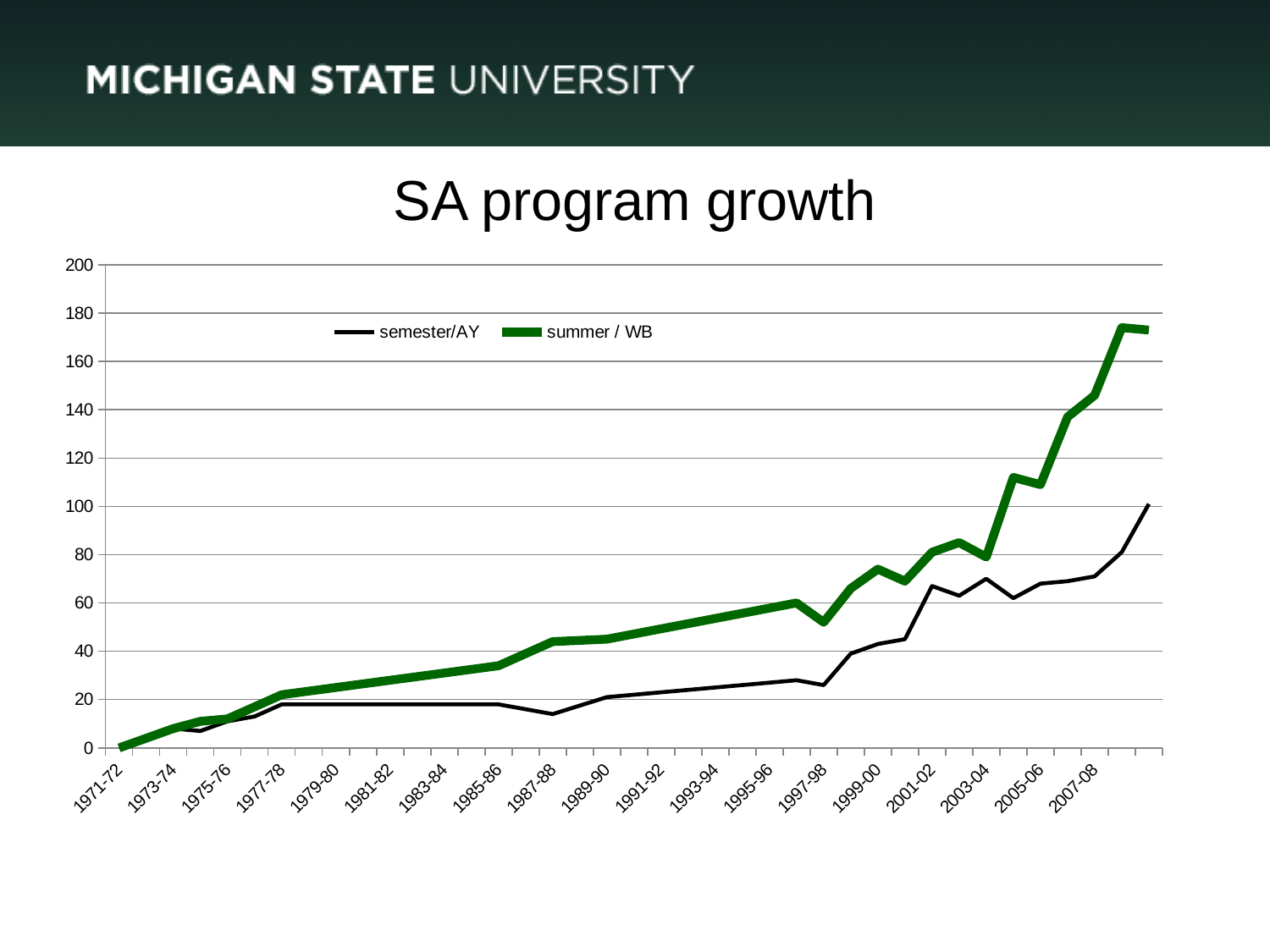
Is the value for summer / WB at 2003-04 greater or less than 100? less What kind of chart is shown on the slide? line chart Is the value for summer / WB at 1997-98 greater or less than 60? less Is the value for semester/AY at 2007-08 greater or less than 60? greater Which series is drawn with the thick green line? summer / WB Which series reaches the highest value on the chart? summer / WB What is the title of the chart? SA program growth At 2005-06, which series has the larger value, semester/AY or summer / WB? summer / WB Do the values for summer / WB generally rise or fall from 1971-72 to the end of the x axis? rise How many series does the legend list? 2